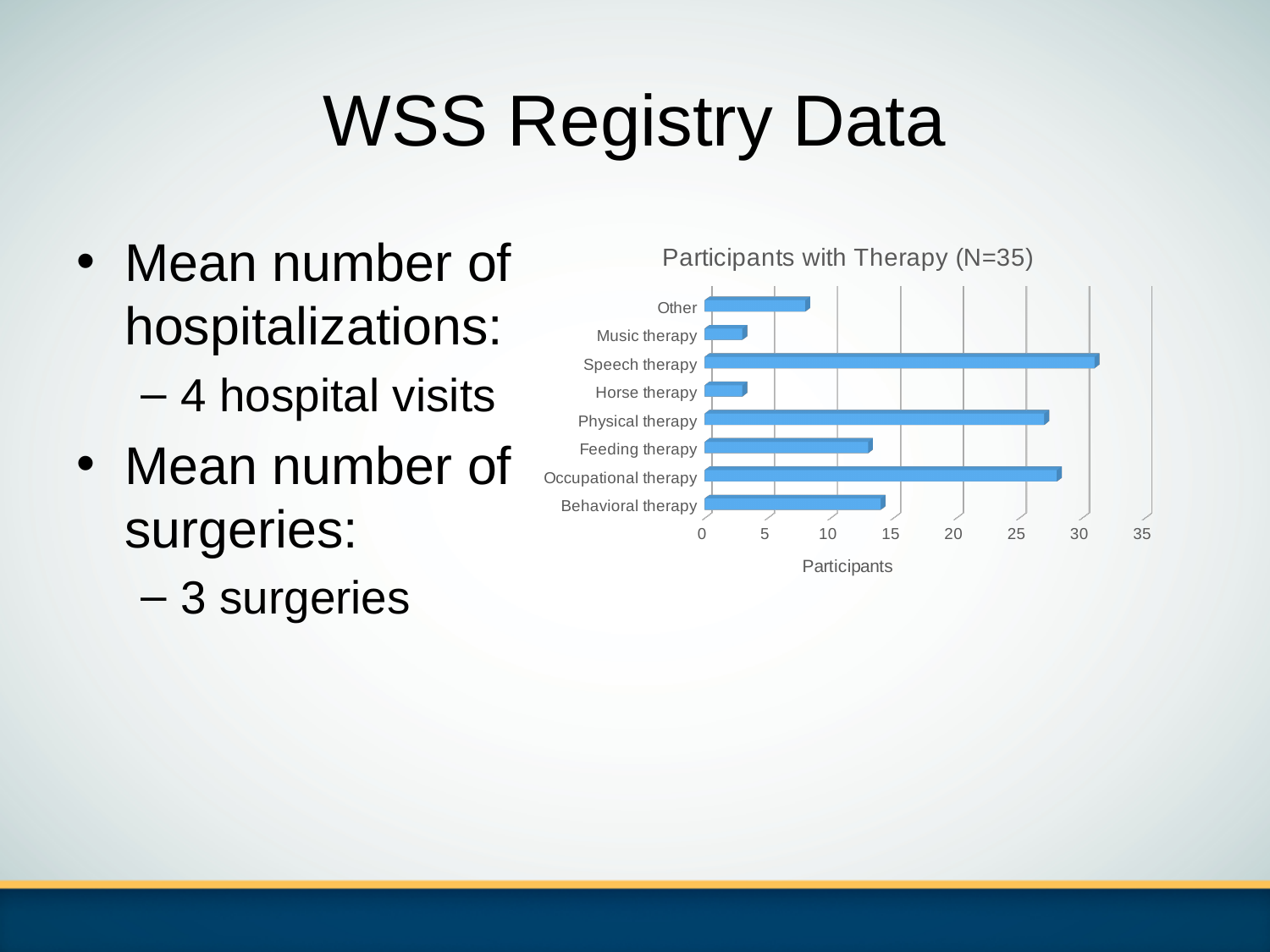
How many therapy categories are plotted in the chart? 8 Is the value for Other greater or less than 10? less Which therapy category has the highest number of participants? Speech therapy What is the title of the chart? Participants with Therapy (N=35) What kind of chart is shown on the slide? bar chart Is the value for Speech therapy greater or less than 25? greater Is the value for Feeding therapy greater or less than 15? less Which has more participants, Physical therapy or Feeding therapy? Physical therapy What is the label on the horizontal axis of the chart? Participants Which has more participants, Occupational therapy or Behavioral therapy? Occupational therapy